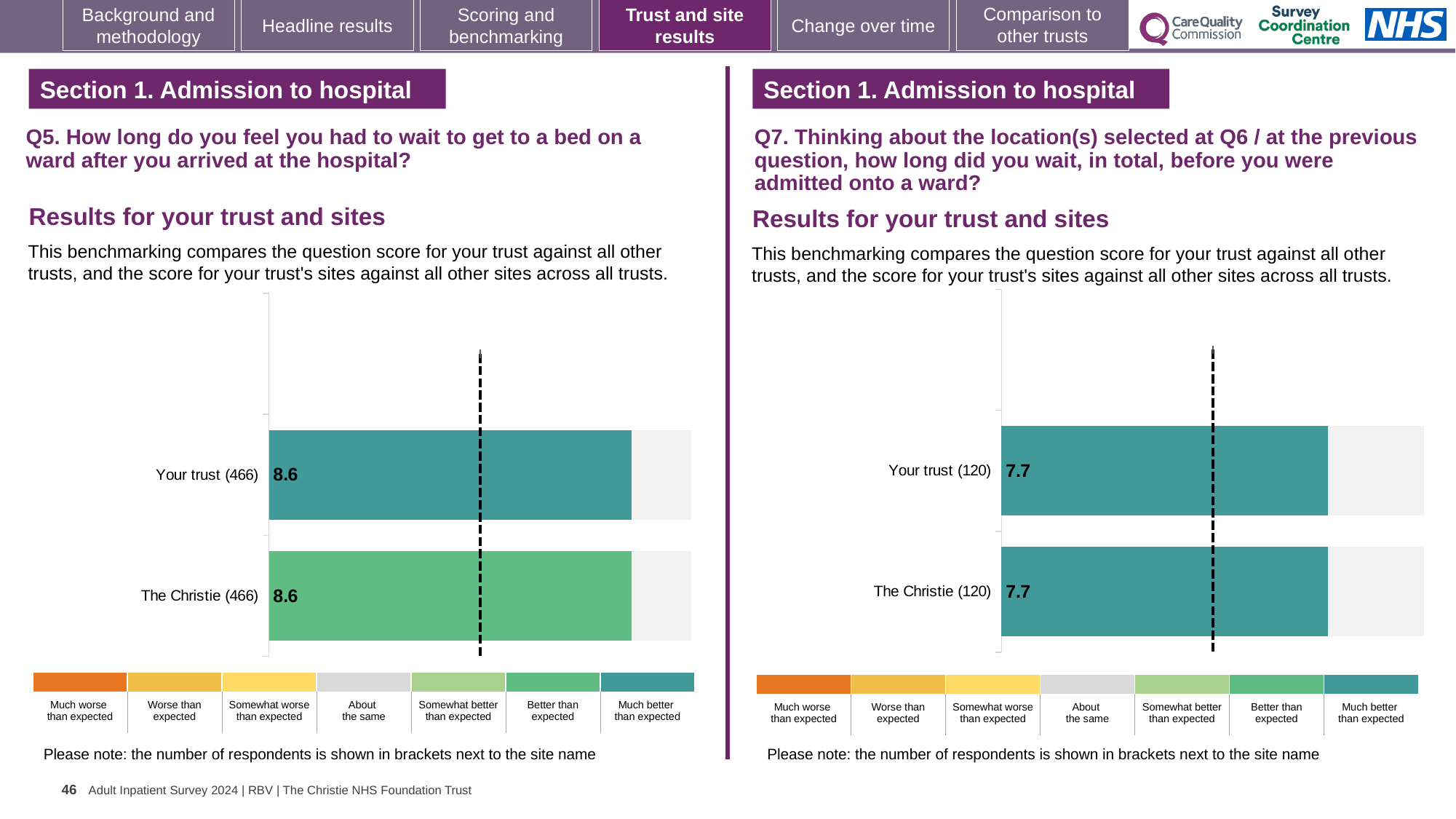
On the Q7 chart (right), what is the score for The Christie? 7.7 On the Q7 chart (right), how many respondents are shown in brackets for Your trust? 120 On the Q5 chart (left), what is the score for Your trust? 8.6 On the Q5 chart (left), what is the difference between the scores for Your trust and The Christie? 0.0 How many bars are plotted on the Q5 chart (left)? 2 What kind of chart is used on the Q7 chart (right)? Bar chart How many bars are plotted on the Q7 chart (right)? 2 On the Q7 chart (right), which benchmark category does the colour of the Your trust bar correspond to in the key? Much better than expected On the Q7 chart (right), what is the score for Your trust? 7.7 On the Q5 chart (left), which benchmark category does the colour of The Christie bar correspond to in the key? Better than expected On the Q5 chart (left), how many respondents are shown in brackets for The Christie? 466 On the Q5 chart (left), what is the score for The Christie? 8.6